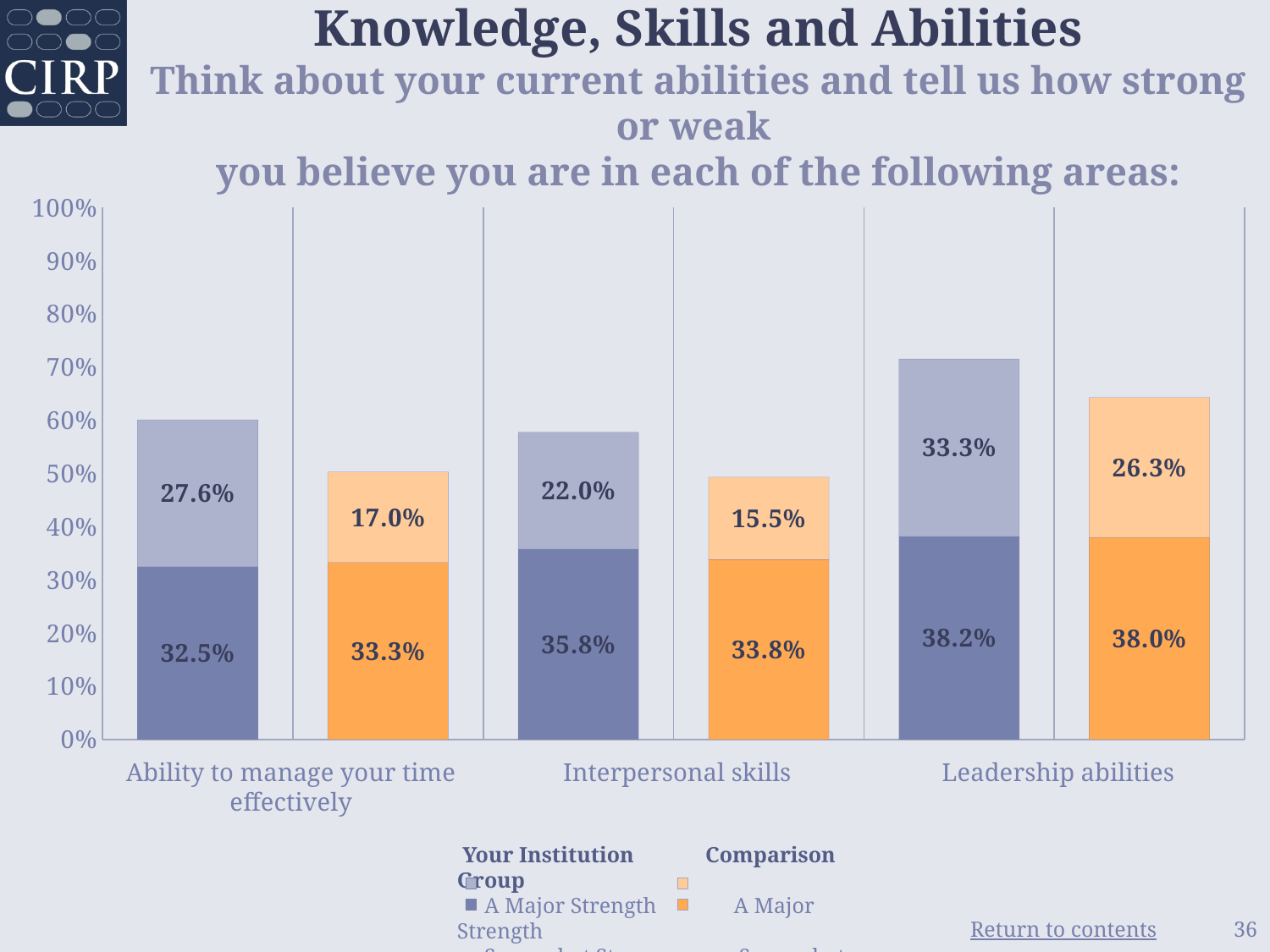
How many categories are shown along the x axis? 3 What is the total height of the Your Institution stacked bar for Leadership abilities? 71.5% What is the 'A Major Strength' value for Your Institution in the Interpersonal skills category? 35.8% What type of chart is shown on the slide? stacked bar chart Is the total of the Comparison Group stacked bar for Interpersonal skills greater or less than 50%? less What is the difference between the Your Institution and Comparison Group upper (lighter) segment values for Interpersonal skills? 6.5% For Ability to manage your time effectively, which is larger: the 'A Major Strength' value for Your Institution or for the Comparison Group? Comparison Group What is the value of the upper (lighter) segment of the Your Institution bar for Leadership abilities? 33.3% Which category has the lowest upper (lighter) segment value for the Comparison Group? Interpersonal skills What is the 'A Major Strength' value for the Comparison Group in the Leadership abilities category? 38.0% Across the three categories, which has the highest 'A Major Strength' value for Your Institution? Leadership abilities What is the value of the upper (lighter) segment of the Comparison Group bar for Ability to manage your time effectively? 17.0%